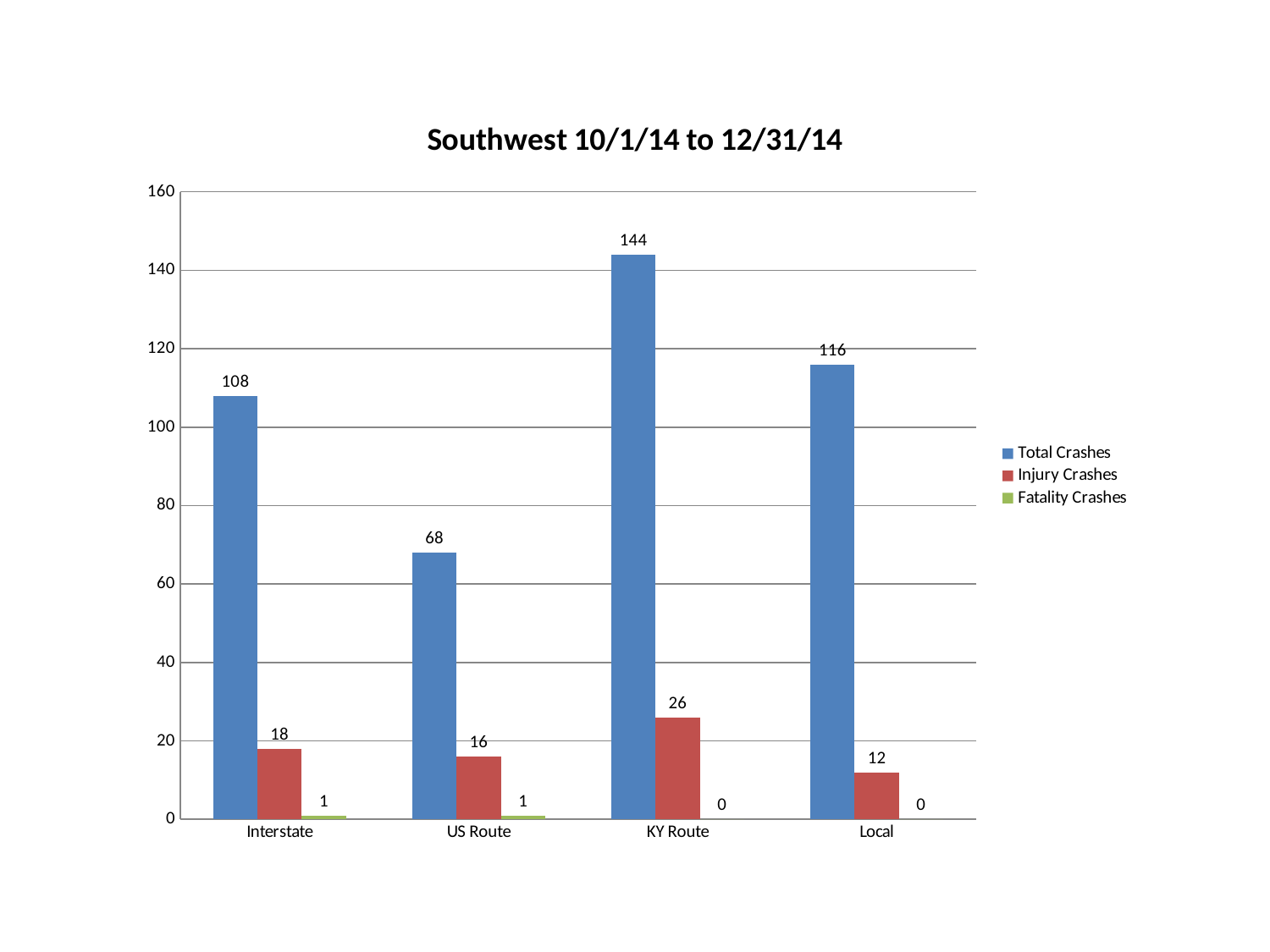
Which category has the highest Total Crashes? KY Route What is the value of Fatality Crashes for US Route? 1 Which is larger, Injury Crashes for Interstate or Injury Crashes for US Route? Interstate What is the title of the chart? Southwest 10/1/14 to 12/31/14 Is the value of Total Crashes for Interstate greater or less than 100? greater What is the value of Injury Crashes for Interstate? 18 What is the value of Total Crashes for KY Route? 144 What is the difference between Total Crashes for KY Route and Local? 28 What kind of chart is shown on the slide? bar chart How many categories are shown on the x axis? 4 Which category has the lowest Total Crashes? US Route How many series does the legend list? 3